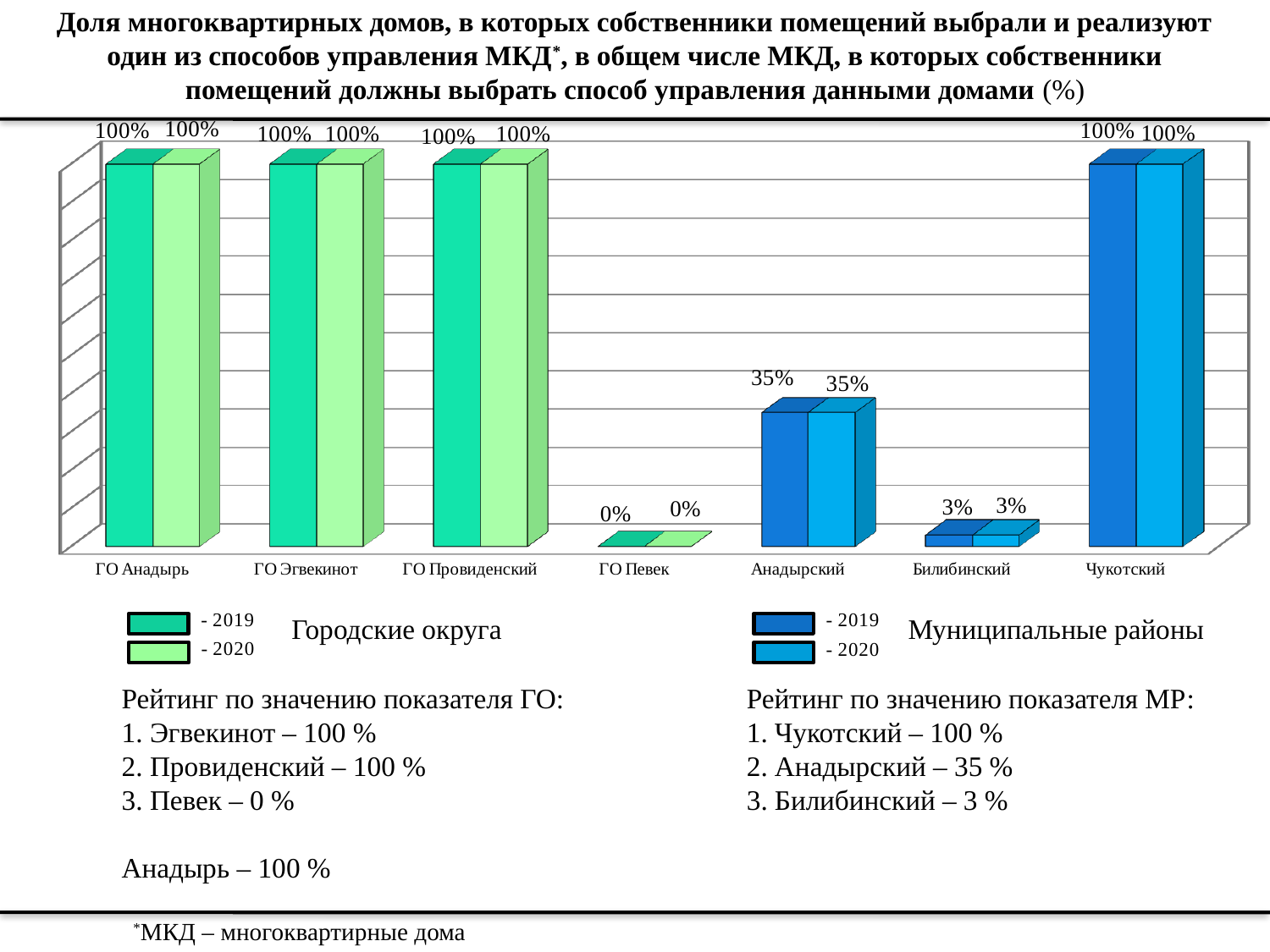
Which years does the chart legend list? 2019 and 2020 What kind of chart is shown on the slide? Bar chart Among the municipal districts (Анадырский, Билибинский, Чукотский), which has the highest value? Чукотский How many categories are shown on the x axis of the chart? 7 What is the 2020 value for ГО Певек? 0% Which category has the lowest values on the chart? ГО Певек What is the 2019 value for Билибинский? 3% What is the 2020 value for Анадырский? 35% What is the 2019 value for Чукотский? 100% Which is larger, the 2020 value for Анадырский or the 2020 value for Билибинский? Анадырский What is the difference between the 2019 values for Чукотский and Анадырский? 65% What is the difference between the 2020 values for Анадырский and Билибинский? 32%